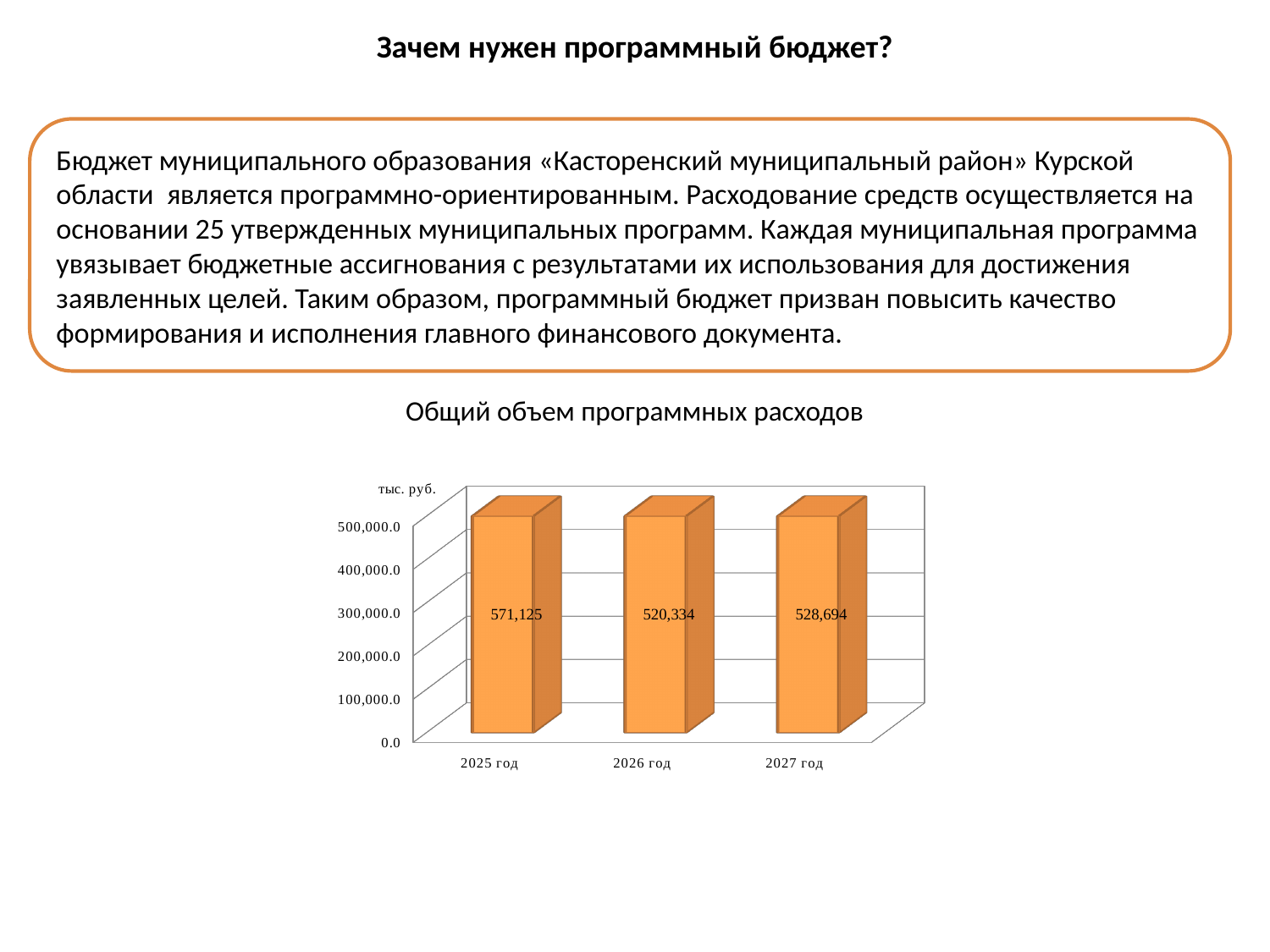
Is the value for 2026 год in the chart 'Общий объем программных расходов' greater or less than 500,000.0? greater What is the value for 2027 год in the chart 'Общий объем программных расходов'? 528,694 What is the value for 2026 год in the chart 'Общий объем программных расходов'? 520,334 Which year has the highest value in the chart 'Общий объем программных расходов'? 2025 год What is the difference between the values for 2025 год and 2026 год in the chart 'Общий объем программных расходов'? 50,791 Which year has the lowest value in the chart 'Общий объем программных расходов'? 2026 год How many years are shown in the chart 'Общий объем программных расходов'? 3 Which is larger in the chart 'Общий объем программных расходов': the value for 2025 год or 2027 год? 2025 год What is the value for 2025 год in the chart 'Общий объем программных расходов'? 571,125 What unit is shown on the vertical axis of the chart 'Общий объем программных расходов'? тыс. руб. What kind of chart is 'Общий объем программных расходов'? bar chart What is the difference between the values for 2027 год and 2026 год in the chart 'Общий объем программных расходов'? 8,360